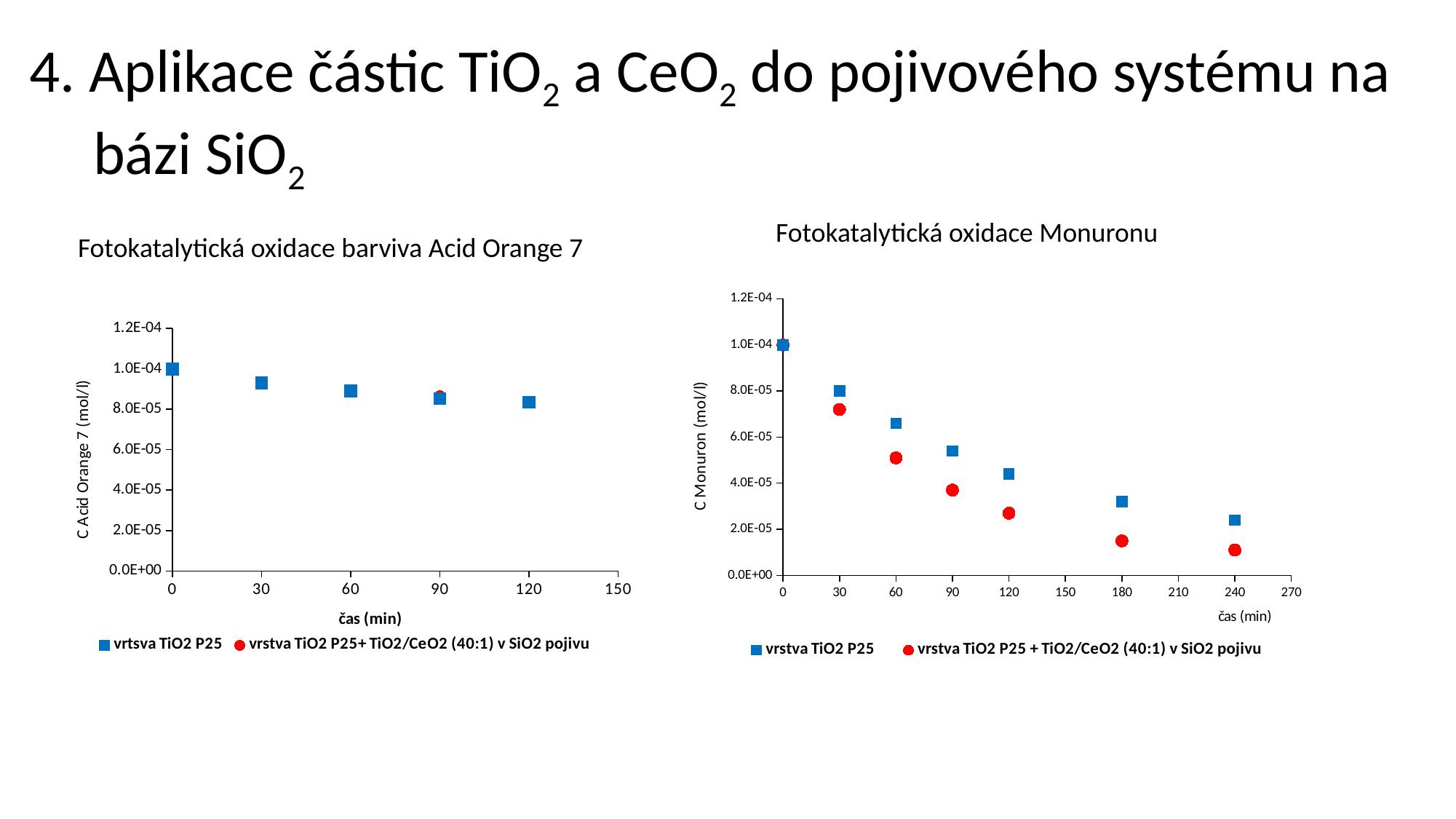
In the 'Fotokatalytická oxidace Monuronu' chart, is the value for 'vrstva TiO2 P25' at 240 min greater or less than 2.0E-05? greater In the 'Fotokatalytická oxidace Monuronu' chart, how many points are plotted for the 'vrstva TiO2 P25' series? 7 In the 'Fotokatalytická oxidace Monuronu' chart, is the value for 'vrstva TiO2 P25 + TiO2/CeO2 (40:1) v SiO2 pojivu' at 30 min greater or less than 8.0E-05? less How many series does the legend of the 'Fotokatalytická oxidace barviva Acid Orange 7' chart list? 2 What is the x-axis label of the 'Fotokatalytická oxidace Monuronu' chart? čas (min) In the 'Fotokatalytická oxidace Monuronu' chart, which series has the larger value at 120 min, 'vrstva TiO2 P25' or 'vrstva TiO2 P25 + TiO2/CeO2 (40:1) v SiO2 pojivu'? vrstva TiO2 P25 In the 'Fotokatalytická oxidace barviva Acid Orange 7' chart, is the value for 'vrtsva TiO2 P25' at 120 min greater or less than 8.0E-05? greater In the 'Fotokatalytická oxidace barviva Acid Orange 7' chart, do the values of the 'vrtsva TiO2 P25' series rise or fall as time increases? fall What kind of chart is the 'Fotokatalytická oxidace Monuronu' chart? scatter chart In the 'Fotokatalytická oxidace Monuronu' chart, do the values of the 'vrstva TiO2 P25' series rise or fall as time increases? fall In the 'Fotokatalytická oxidace barviva Acid Orange 7' chart, how many points are plotted for the 'vrtsva TiO2 P25' series? 5